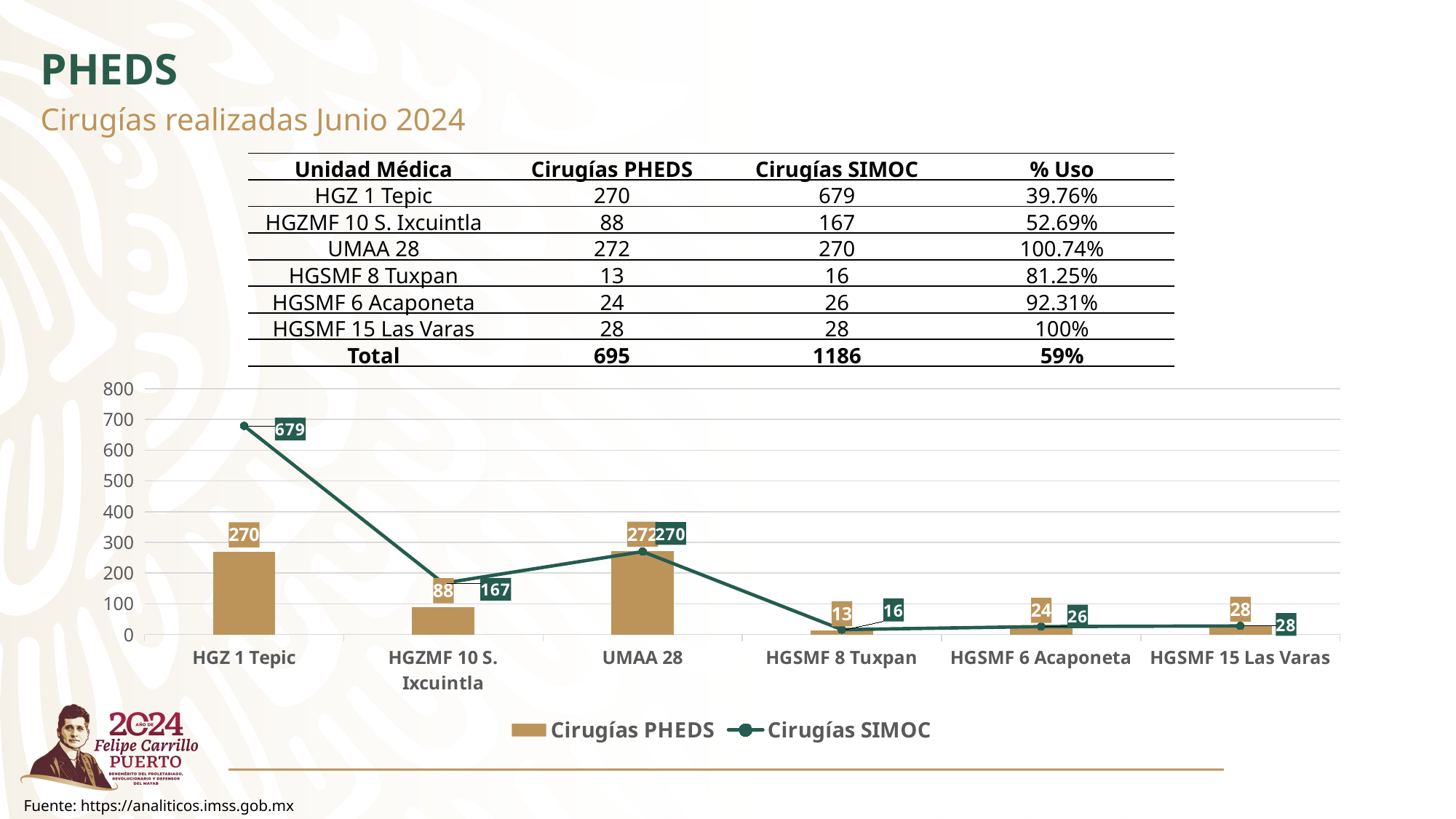
What is the Cirugías PHEDS value for UMAA 28? 272 What is the Cirugías SIMOC value for HGZMF 10 S. Ixcuintla? 167 Which is larger for UMAA 28, Cirugías PHEDS or Cirugías SIMOC? Cirugías PHEDS Which unit has the highest Cirugías SIMOC value? HGZ 1 Tepic What is the difference between Cirugías SIMOC and Cirugías PHEDS for HGZ 1 Tepic? 409 Which series is drawn as a line with markers in the chart? Cirugías SIMOC How many series does the chart legend list? 2 Is the Cirugías SIMOC value for HGZ 1 Tepic greater or less than 600? greater Which unit has the lowest Cirugías PHEDS value? HGSMF 8 Tuxpan What kind of chart is used for the Cirugías PHEDS series? Bar chart What is the Cirugías PHEDS value for HGZ 1 Tepic? 270 How many medical units are shown on the x axis of the chart? 6